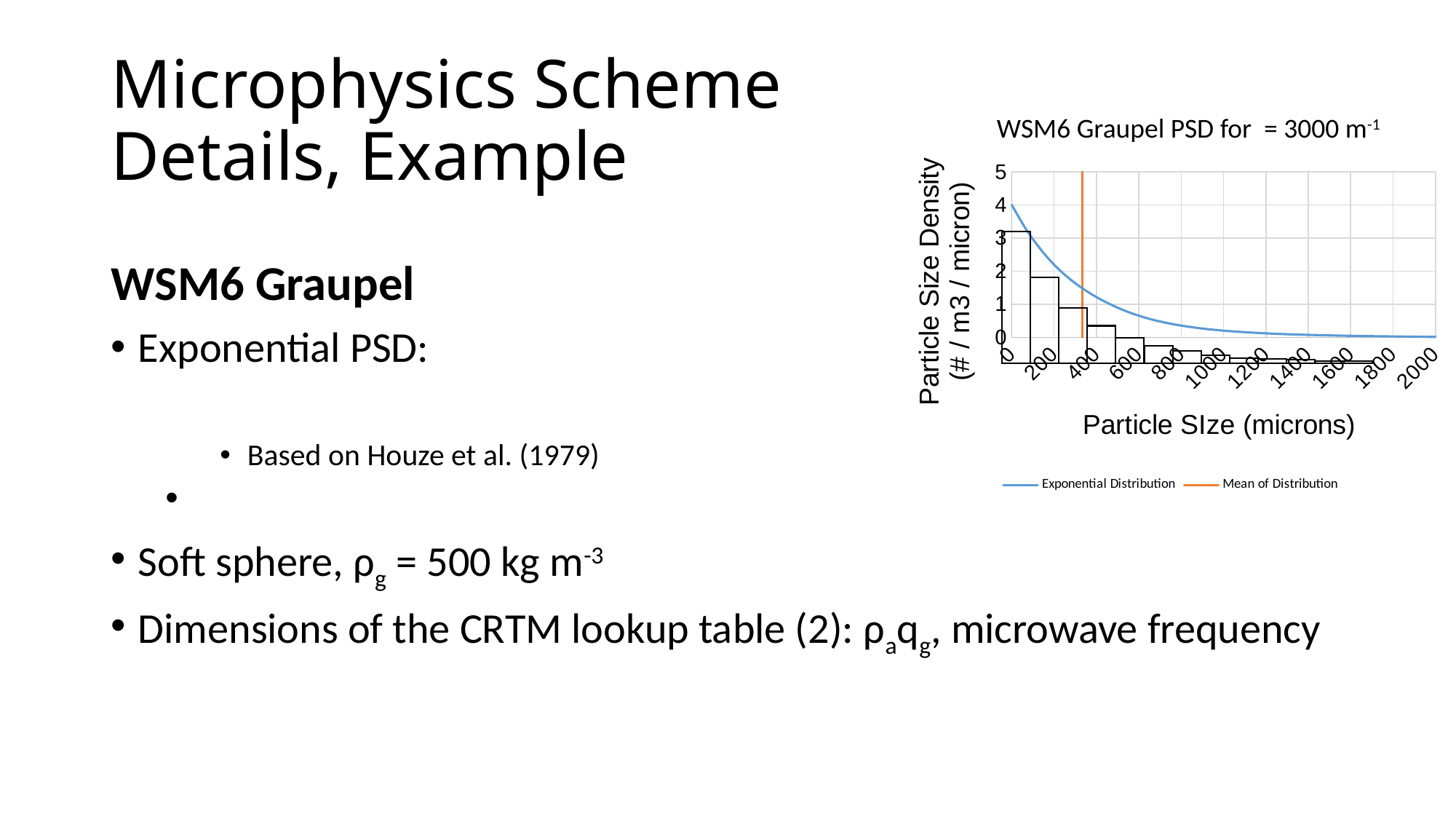
Is the Exponential Distribution value at a particle size of 1000 microns greater or less than 1? less What is the title of the chart on the slide? WSM6 Graupel PSD for = 3000 m-1 Is the Exponential Distribution value at a particle size of 2000 microns greater or less than 1? less What is the largest particle size shown on the x axis of the chart? 2000 How many series does the chart legend list? 2 What is the label of the x axis of the chart? Particle SIze (microns) Is the Mean of Distribution located at a particle size greater or less than 600 microns? less Which is larger, the Exponential Distribution value at 200 microns or at 800 microns? 200 microns Does the Exponential Distribution rise or fall as particle size increases along the x axis? fall